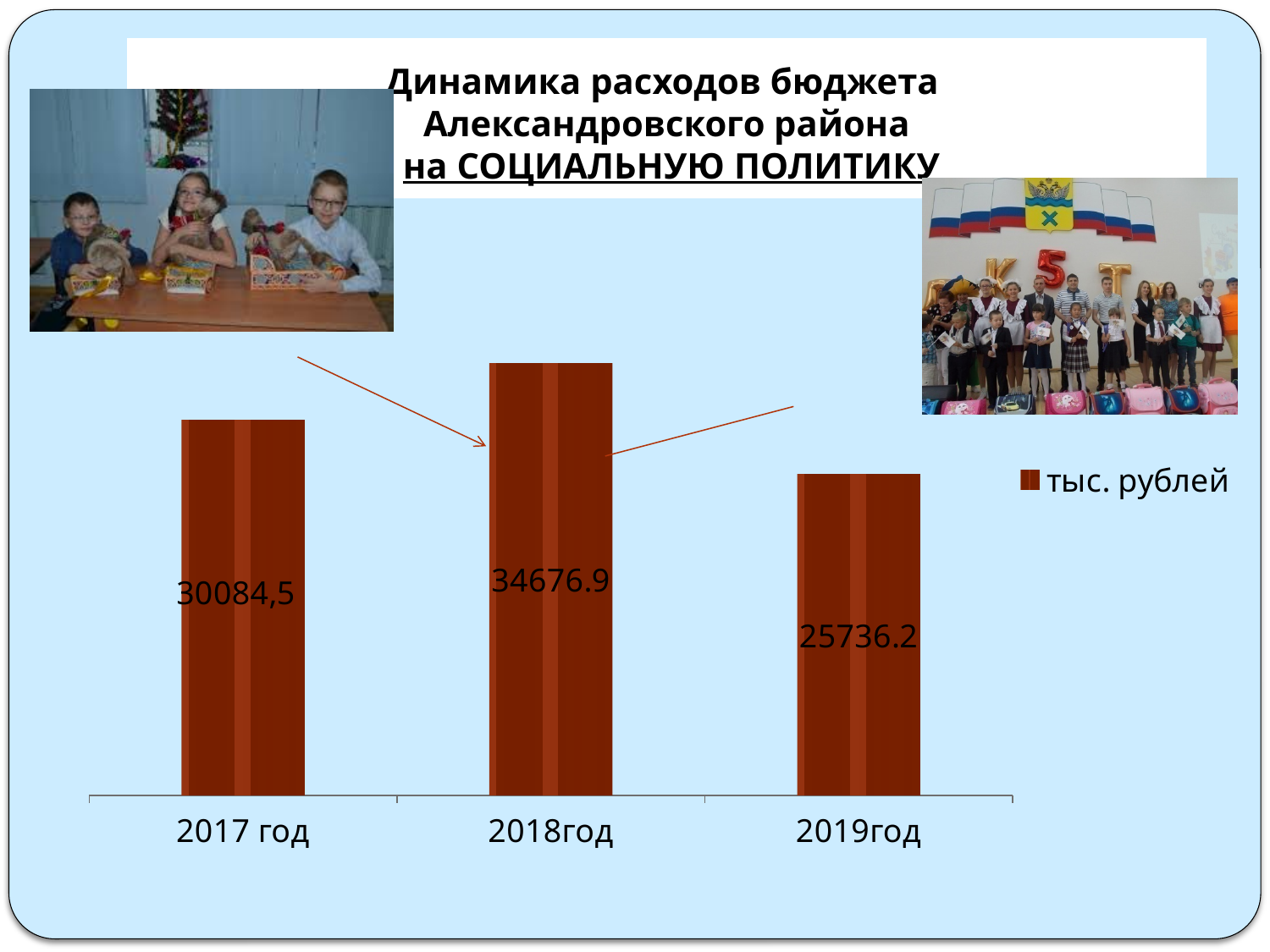
How many bars are shown in the chart? 3 What is the value for 2017 год? 30084,5 What is the difference between the values for 2018год and 2019год? 8940.7 What is the value for 2018год? 34676.9 How many series does the legend list? 1 What kind of chart is shown on the slide? Bar chart Do the values rise or fall from 2018год to 2019год? Fall Which year has the lowest value? 2019год Which is larger, the value for 2017 год or the value for 2019год? 2017 год Which year has the highest value? 2018год What series name is shown in the legend? тыс. рублей What is the value for 2019год? 25736.2